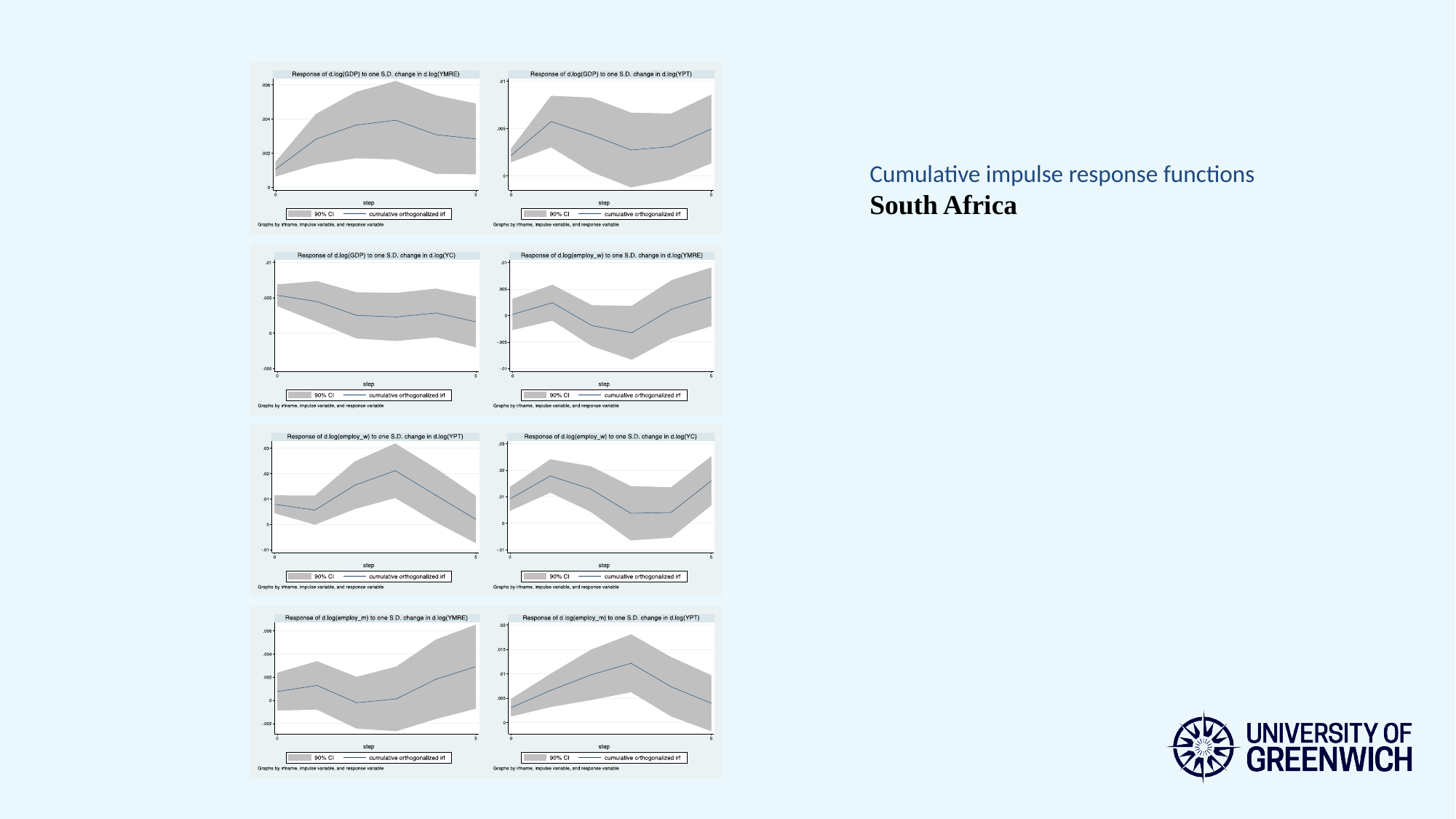
How many charts are shown on the slide? 8 In the chart 'Response of d.log(employ_w) to one S.D. change in d.log(YMRE)', at which step does the irf line reach its lowest value? step 3 In the chart 'Response of d.log(employ_w) to one S.D. change in d.log(YC)', is the value of the irf line at step 1 greater or less than .01? greater What kind of chart is the top-left chart, 'Response of d.log(GDP) to one S.D. change in d.log(YMRE)'? line chart In the top-left chart, 'Response of d.log(GDP) to one S.D. change in d.log(YMRE)', is the value of the irf line at step 3 greater or less than .002? greater In the top-left chart, 'Response of d.log(GDP) to one S.D. change in d.log(YMRE)', at which step does the cumulative orthogonalized irf line reach its highest value? step 3 In the chart 'Response of d.log(GDP) to one S.D. change in d.log(YPT)', is the value of the irf line at step 3 greater or less than .005? less In the bottom-right chart, 'Response of d.log(employ_m) to one S.D. change in d.log(YPT)', does the irf line rise or fall between step 3 and step 5? fall In the chart 'Response of d.log(employ_w) to one S.D. change in d.log(YPT)', does the irf line rise or fall between step 1 and step 3? rise What confidence level does the shaded band in the charts represent, according to the legend? 90% CI What is the label of the x axis on the charts? step How many entries does the legend of the top-left chart, 'Response of d.log(GDP) to one S.D. change in d.log(YMRE)', list? 2